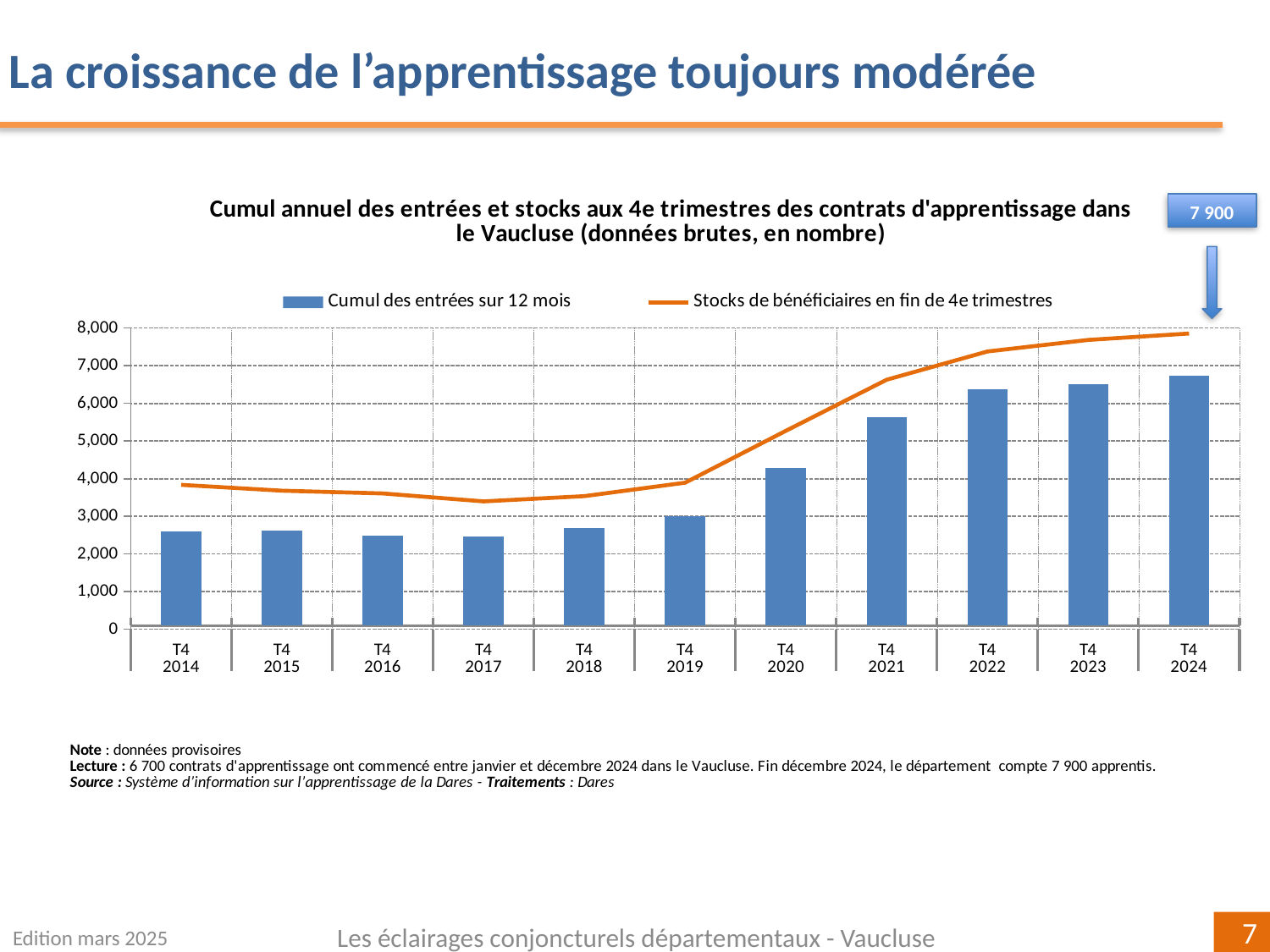
Is the bar value for 'Cumul des entrées sur 12 mois' at T4 2021 greater or less than 5,000? greater In which quarter is the line 'Stocks de bénéficiaires en fin de 4e trimestres' at its lowest? T4 2017 Which series is drawn as an orange line? Stocks de bénéficiaires en fin de 4e trimestres What kind of chart is shown on the slide? A combined bar and line chart In which quarter is the bar for 'Cumul des entrées sur 12 mois' the highest? T4 2024 Is the value of the 'Stocks de bénéficiaires' line at T4 2022 greater or less than 7,000? greater How many quarters (categories) are shown along the x axis? 11 Do the 'Cumul des entrées sur 12 mois' bars rise or fall from T4 2019 to T4 2024? rise What is the value of the stock of beneficiaries (Stocks de bénéficiaires) at T4 2024, as shown in the callout? 7 900 Which is larger: the 'Cumul des entrées sur 12 mois' bar at T4 2022 or at T4 2019? T4 2022 Is the value of the 'Stocks de bénéficiaires' line at T4 2014 greater or less than 4,000? less How many series does the chart legend list? 2